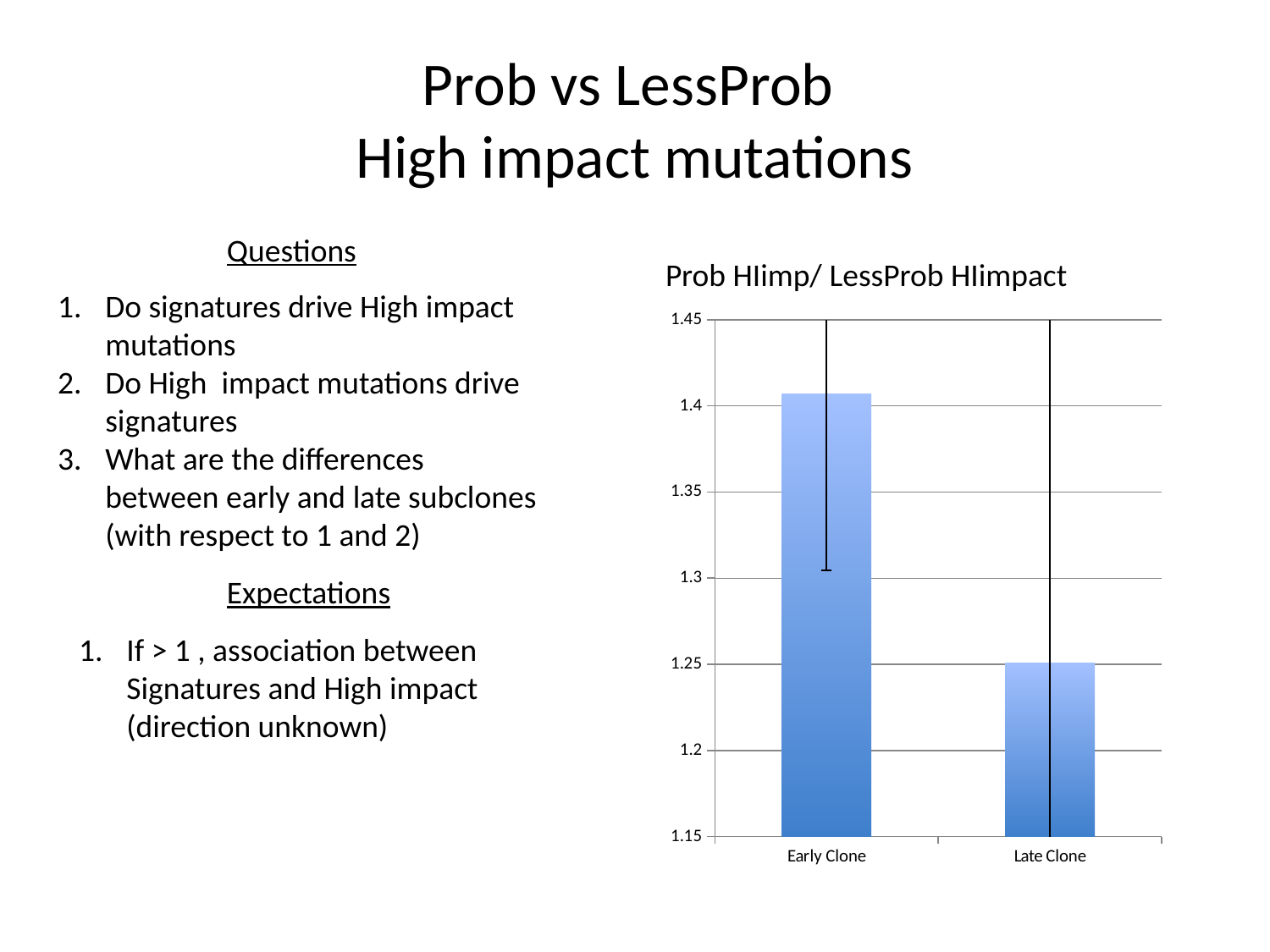
How many categories are plotted on the x axis of the chart? 2 Is the value for Early Clone greater or less than 1.35? greater Is the value for Late Clone greater or less than 1.3? less Which is larger, the value for Early Clone or the value for Late Clone? Early Clone What is the highest value shown on the chart's y axis? 1.45 Do the bar values rise or fall from Early Clone to Late Clone? fall Which category has the lowest value in the chart? Late Clone Which category has the highest value in the chart? Early Clone What is the title of the chart? Prob HIimp/ LessProb HIimpact What kind of chart is shown on the slide? bar chart Is the value for Late Clone greater or less than 1.2? greater